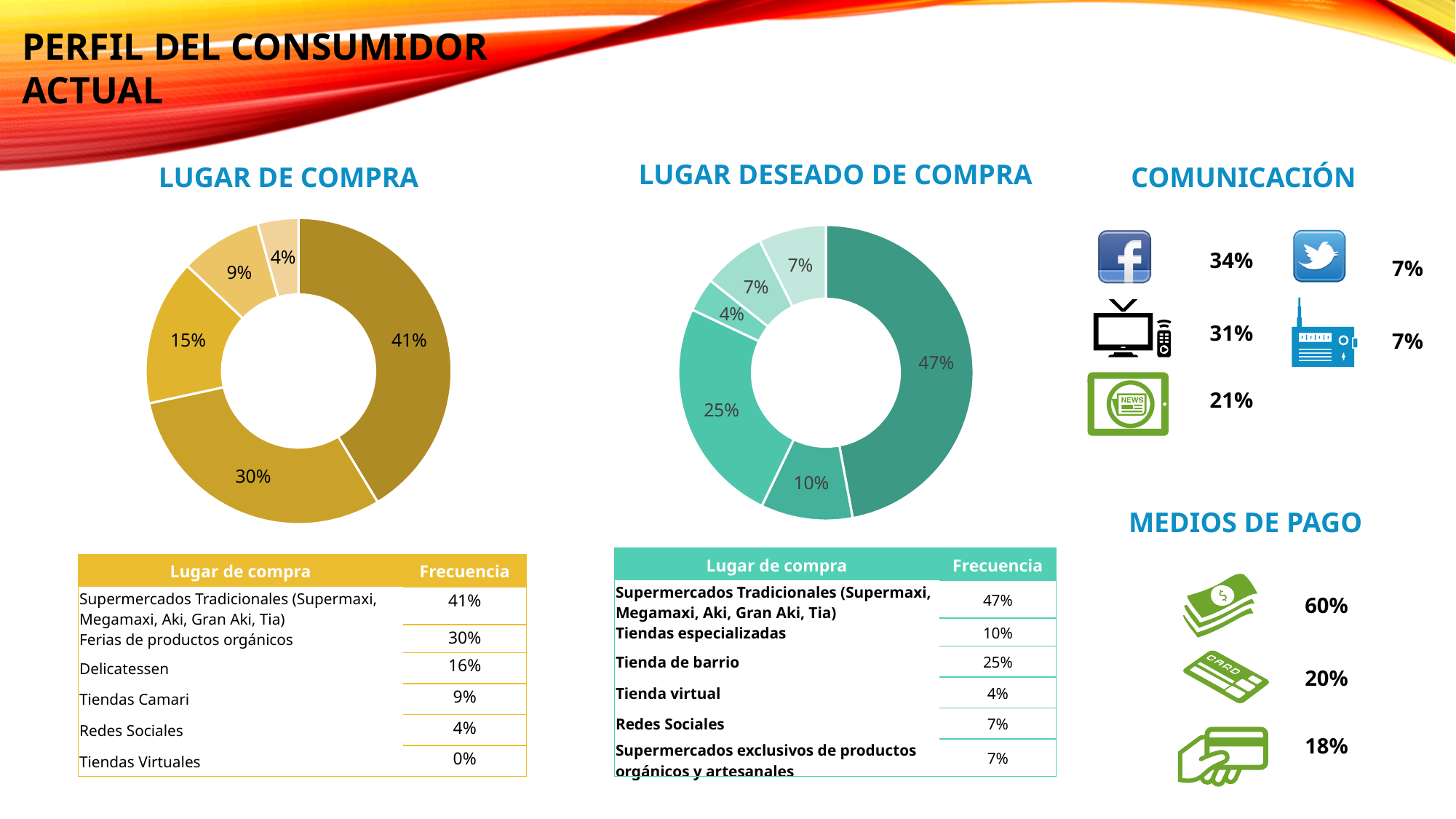
In the LUGAR DESEADO DE COMPRA chart, which is larger: Tiendas especializadas or Tienda virtual? Tiendas especializadas In the LUGAR DE COMPRA chart, what is the difference between the 41% slice and the 30% slice? 11% In the LUGAR DESEADO DE COMPRA chart, what is the smallest slice's value? 4% In the LUGAR DE COMPRA chart, what share is shown for Ferias de productos orgánicos? 30% How many slices are visible in the LUGAR DE COMPRA donut chart? 5 In the LUGAR DESEADO DE COMPRA chart, what share is shown for Supermercados Tradicionales? 47% What kind of chart is the LUGAR DE COMPRA chart? Pie chart (donut) In the LUGAR DE COMPRA chart, what is the largest slice's value? 41% How many slices does the LUGAR DESEADO DE COMPRA donut chart have? 6 In the LUGAR DE COMPRA chart, what is the smallest labelled slice's value? 4% What is the title of the chart on the left of the slide? LUGAR DE COMPRA In the LUGAR DESEADO DE COMPRA chart, what share is shown for Tienda de barrio? 25%